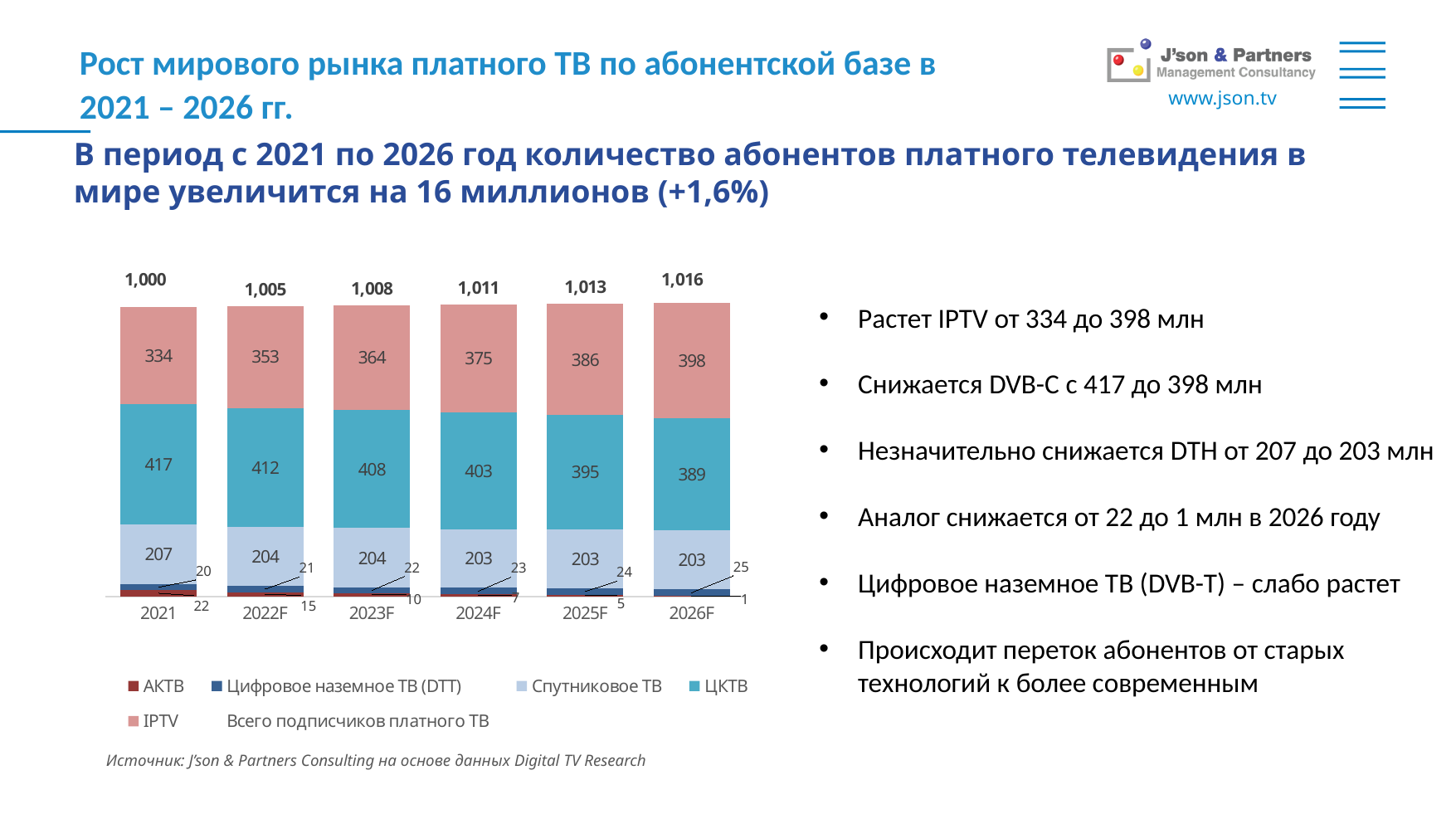
What is the IPTV value for 2021? 334 In which year is the ЦКТВ value lowest? 2026F What is the difference between the ЦКТВ value in 2021 and in 2026F? 28 Which is larger in 2023F: the IPTV value or the ЦКТВ value? ЦКТВ What is the total number of pay TV subscribers (Всего подписчиков платного ТВ) shown for 2024F? 1,011 What is the Спутниковое ТВ value for 2022F? 204 What is the АКТВ value for 2026F? 1 How many series does the legend list? 6 In which year is the IPTV value highest? 2026F How many years (categories) are shown on the x axis? 6 Does the IPTV value rise or fall from 2021 to 2026F? rise What is the ЦКТВ value for 2026F? 389